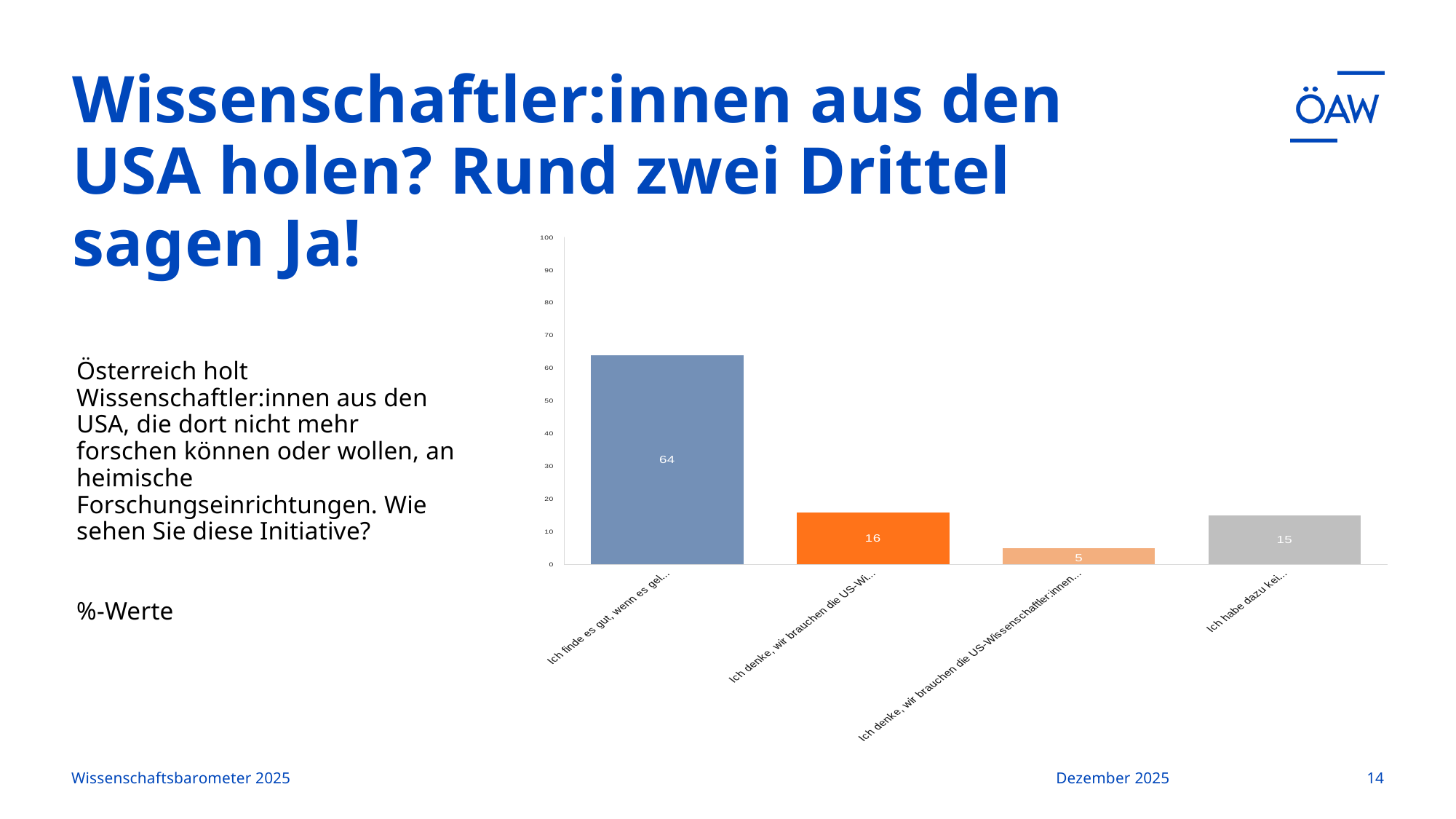
Which is larger, the value of the first bar or the value of the fourth bar? The first bar (64) What is the value of the third bar, the light orange one? 5 Is the value of the first bar greater or less than 50? greater Which bar has the lowest value in the chart? The third bar, 5 What is the difference between the second bar (16) and the fourth bar (15)? 1 What is the difference between the first bar (64) and the second bar (16)? 48 What is the value of the orange bar, the second from the left? 16 What is the value of the grey bar on the far right, labelled "Ich habe dazu kei..."? 15 Which bar has the highest value in the chart? The first bar ("Ich finde es gut, wenn es gel..."), 64 How many bars are shown in the chart? 4 What is the value of the first (leftmost) bar in the chart? 64 What type of chart is shown on the slide? Bar chart